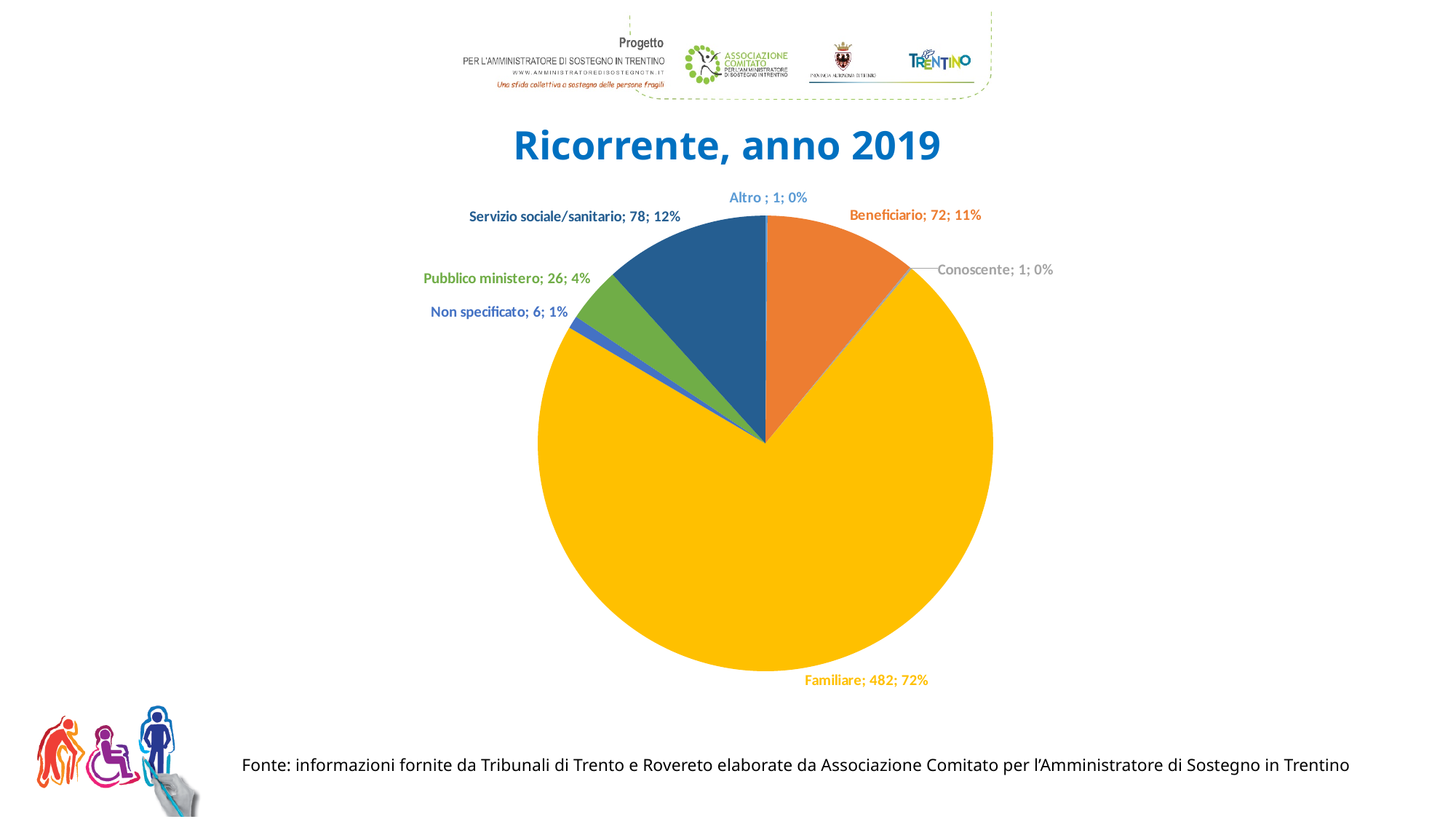
How many categories (slices) does the pie chart have? 7 Which is larger, the value for Pubblico ministero or the value for Non specificato? Pubblico ministero What is the value for Non specificato? 6 What is the title of the chart? Ricorrente, anno 2019 What is the difference between the values for Servizio sociale/sanitario and Beneficiario? 6 What share of the pie does Beneficiario represent? 11% What is the value for Servizio sociale/sanitario? 78 Which category has the largest slice of the pie? Familiare What is the value for Familiare? 482 What kind of chart is shown on the slide? pie chart What is the value for Pubblico ministero? 26 What share of the pie does Familiare represent? 72%